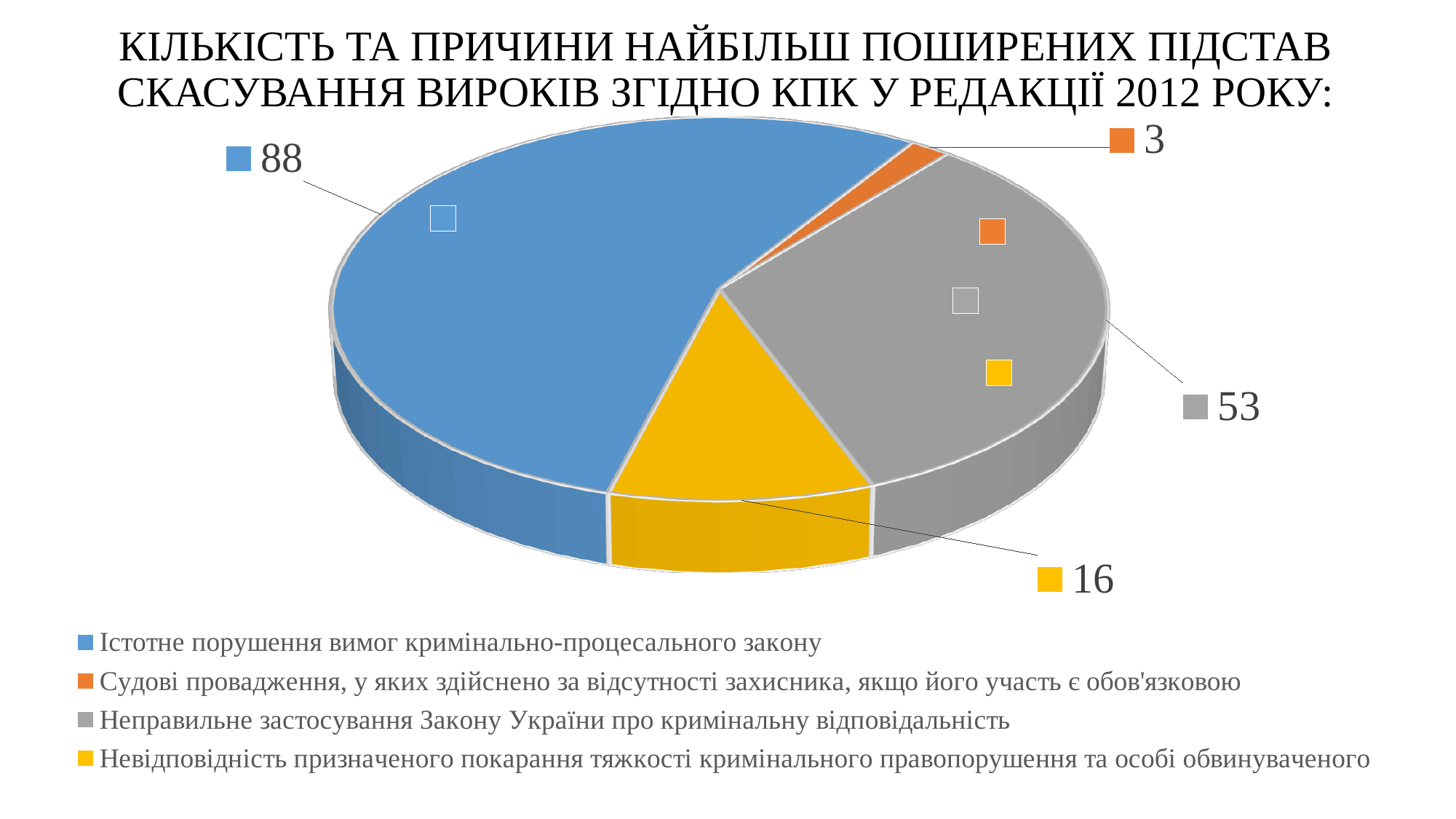
What colour is the slice for "Неправильне застосування Закону України про кримінальну відповідальність"? gray What is the value for "Невідповідність призначеного покарання тяжкості кримінального правопорушення та особі обвинуваченого"? 16 Which category has the largest slice of the pie? Істотне порушення вимог кримінально-процесального закону What is the value for "Істотне порушення вимог кримінально-процесального закону"? 88 What is the difference between the value for "Істотне порушення вимог кримінально-процесального закону" and the value for "Неправильне застосування Закону України про кримінальну відповідальність"? 35 What is the value for "Неправильне застосування Закону України про кримінальну відповідальність"? 53 How many categories does the pie chart have? 4 What kind of chart is shown on the slide? pie chart Which category has the smallest slice of the pie? Судові провадження, у яких здійснено за відсутності захисника, якщо його участь є обов'язковою Which is larger: the value for "Неправильне застосування Закону України про кримінальну відповідальність" or the value for "Невідповідність призначеного покарання тяжкості кримінального правопорушення та особі обвинуваченого"? Неправильне застосування Закону України про кримінальну відповідальність What is the value for "Судові провадження, у яких здійснено за відсутності захисника, якщо його участь є обов'язковою"? 3 What share of the pie does "Невідповідність призначеного покарання тяжкості кримінального правопорушення та особі обвинуваченого" represent? 10%